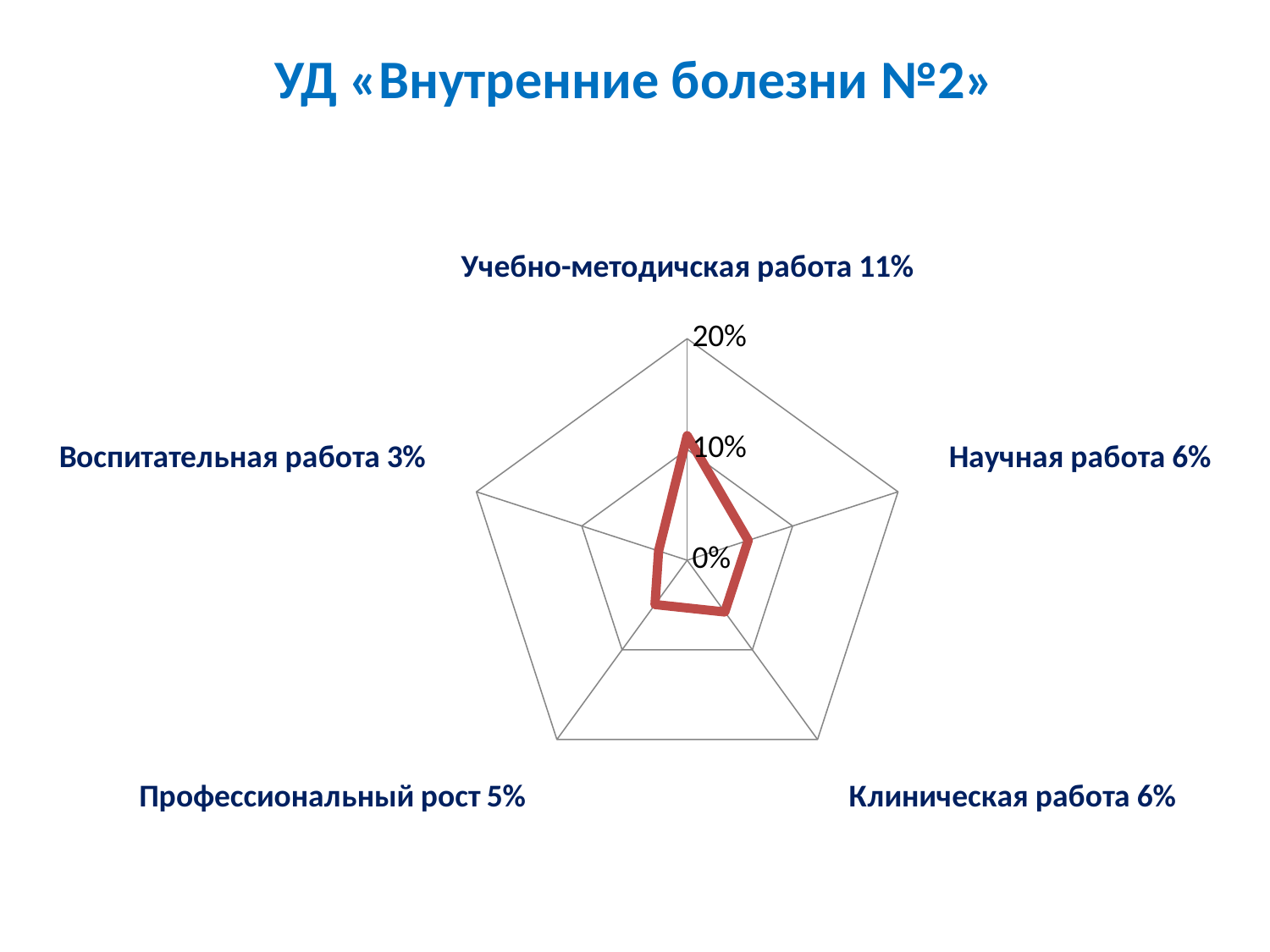
What is the value for Научная работа? 6% Which category has the highest value? Учебно-методичская работа What is the value for Профессиональный рост? 5% What is the title of the chart on the slide? УД «Внутренние болезни №2» Which category has the lowest value? Воспитательная работа What is the value for Воспитательная работа? 3% What is the difference between the values for Учебно-методичская работа and Воспитательная работа? 8% Is the value for Учебно-методичская работа greater or less than 10%? greater What kind of chart is shown on the slide? Radar chart Which is larger, the value for Профессиональный рост or the value for Воспитательная работа? Профессиональный рост How many categories (axes) does the radar chart have? 5 What is the value for Учебно-методичская работа? 11%